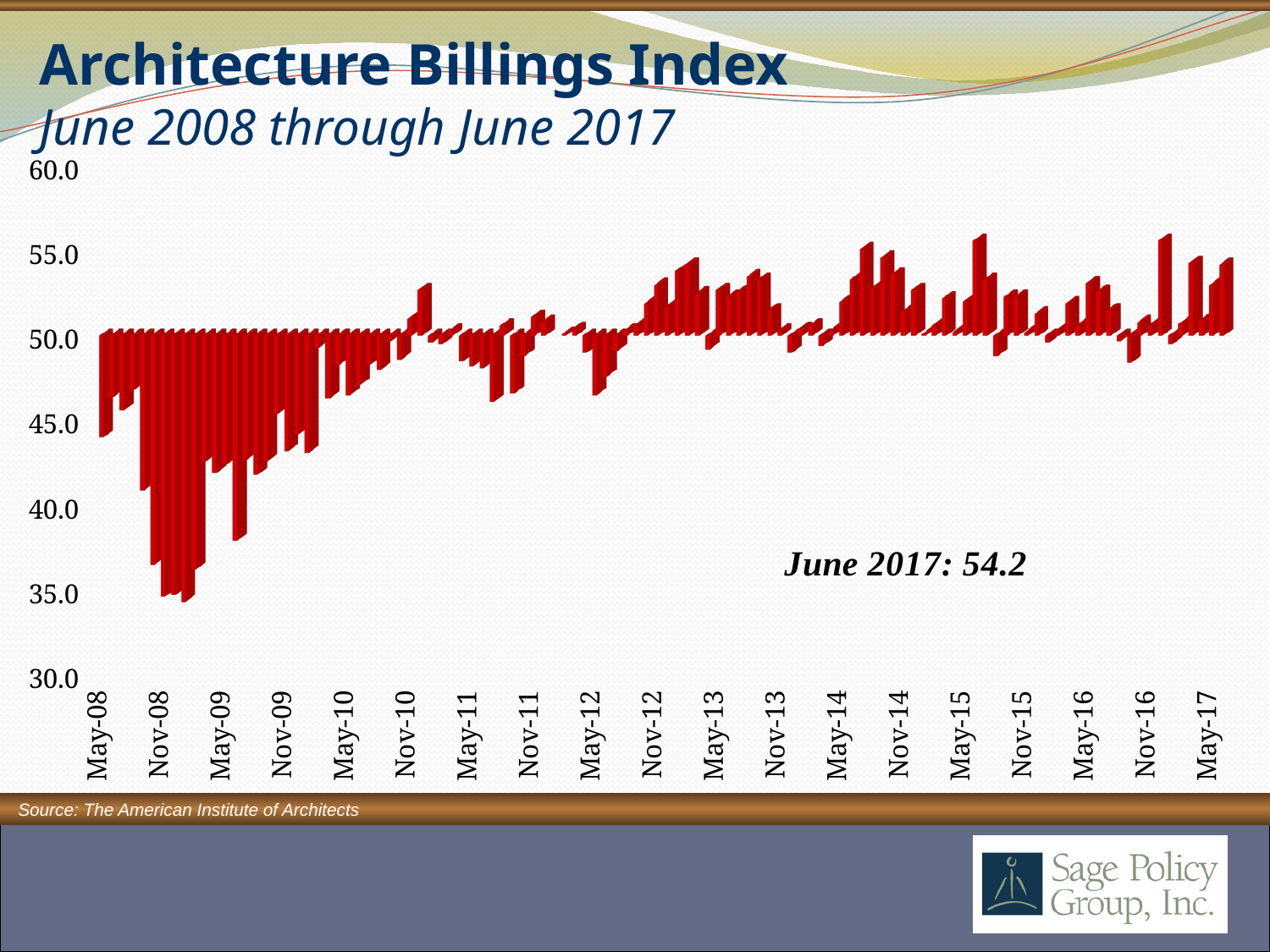
What kind of chart is shown on the slide? Bar chart Is the value for May-17 greater or less than 50.0? greater Is the lowest value on the chart above or below 40.0? below Is the value for Nov-08 greater or less than 40.0? less How many date labels are shown on the x axis? 19 What is the value of the Architecture Billings Index for June 2017, as printed on the slide? 54.2 What is the source cited for the chart? The American Institute of Architects Is the value for May-13 greater or less than 50.0? greater Which is larger, the value for Nov-08 or the value for May-17? May-17 What period does the chart cover, according to the subtitle? June 2008 through June 2017 Do the values rise or fall between Nov-08 and May-10? rise